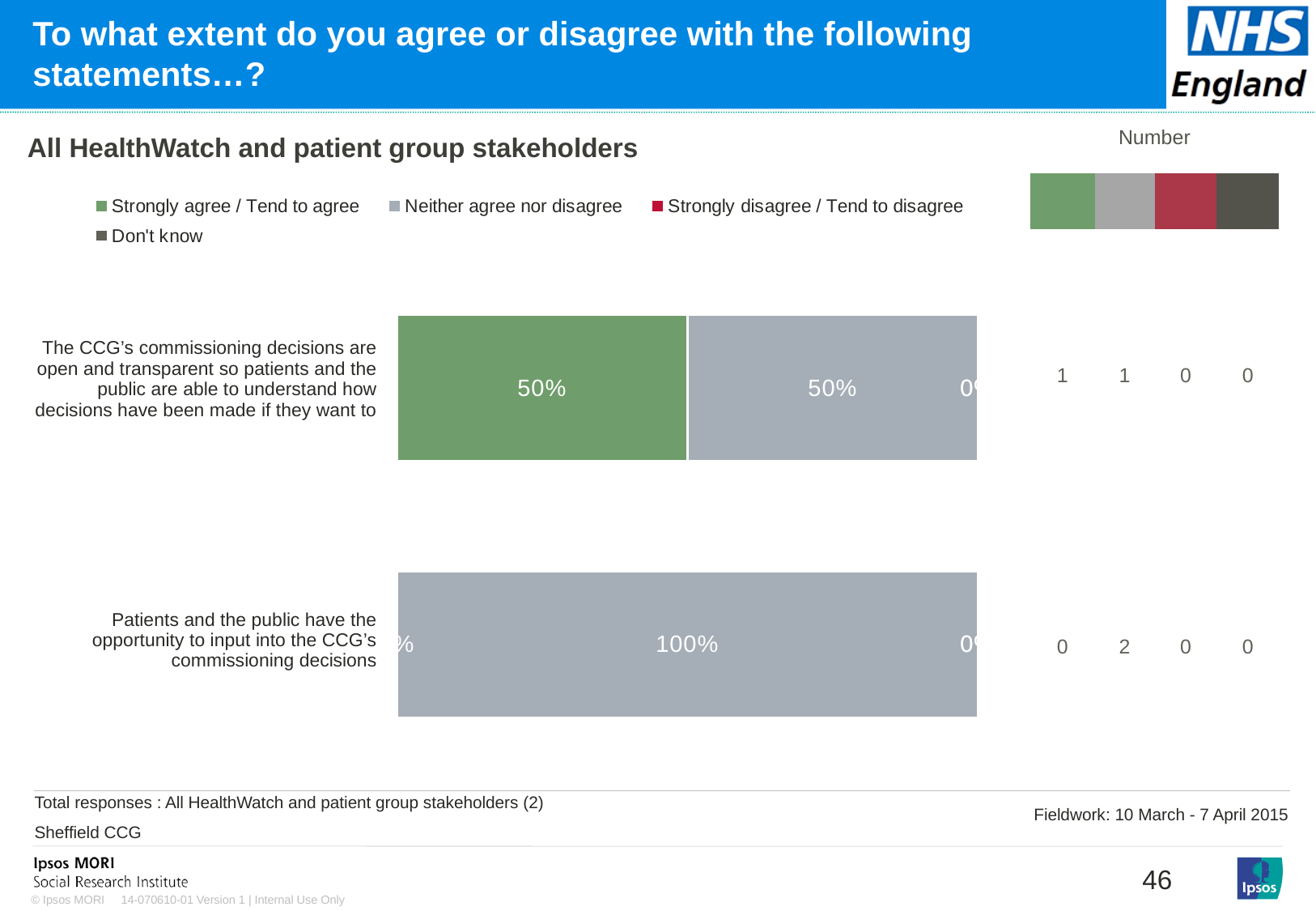
In the Number column, how many respondents neither agree nor disagree that patients and the public have the opportunity to input into the CCG's commissioning decisions? 2 What kind of chart is shown on the slide? Stacked bar chart In the Number column, how many respondents strongly agree / tend to agree that the CCG's commissioning decisions are open and transparent? 1 How many series does the legend list? 4 What percentage of stakeholders neither agree nor disagree that patients and the public have the opportunity to input into the CCG's commissioning decisions? 100% What percentage of stakeholders neither agree nor disagree that the CCG's commissioning decisions are open and transparent? 50% Which legend entry is shown in green? Strongly agree / Tend to agree How many statements are plotted in the chart? 2 What is the difference between the 'Neither agree nor disagree' share for the second statement and the first statement? 50% Which statement has the larger 'Neither agree nor disagree' share? Patients and the public have the opportunity to input into the CCG's commissioning decisions What percentage of stakeholders strongly agree / tend to agree that the CCG's commissioning decisions are open and transparent? 50% What is the total number of responses shown for the statement about patients and the public having the opportunity to input into commissioning decisions? 2